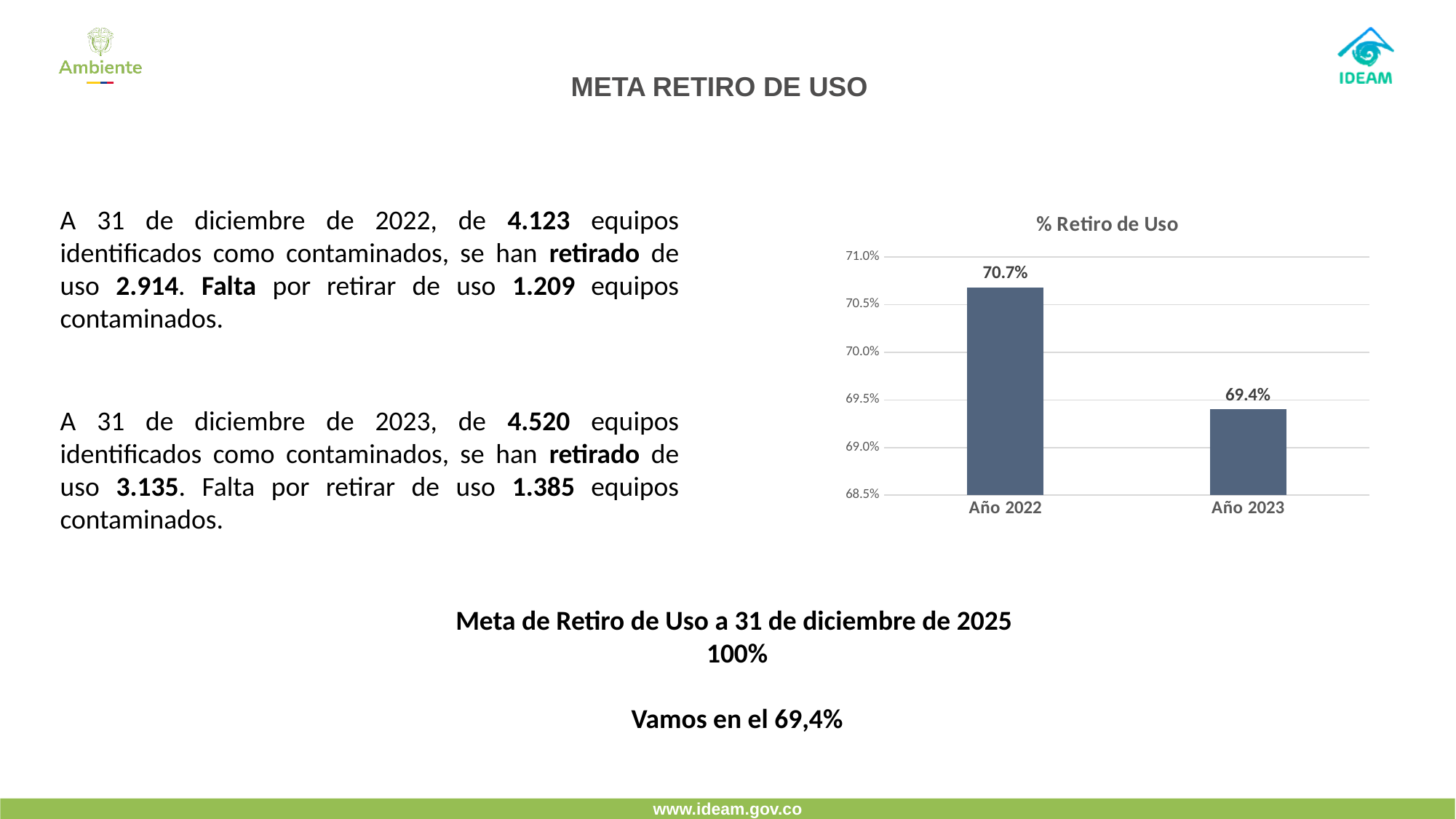
Which year has the lowest % Retiro de Uso? Año 2023 What is the value for Año 2023 in the chart? 69.4% What is the difference between the values for Año 2022 and Año 2023? 1.3% What kind of chart is shown on the slide? Bar chart Which year has the highest % Retiro de Uso? Año 2022 What is the title of the chart? % Retiro de Uso How many categories are shown in the chart? 2 Is the value for Año 2022 greater or less than 70.5%? greater Do the values rise or fall from Año 2022 to Año 2023? Fall Which is larger, the value for Año 2022 or Año 2023? Año 2022 What is the value for Año 2022 in the chart? 70.7% Is the value for Año 2023 greater or less than 70.0%? less